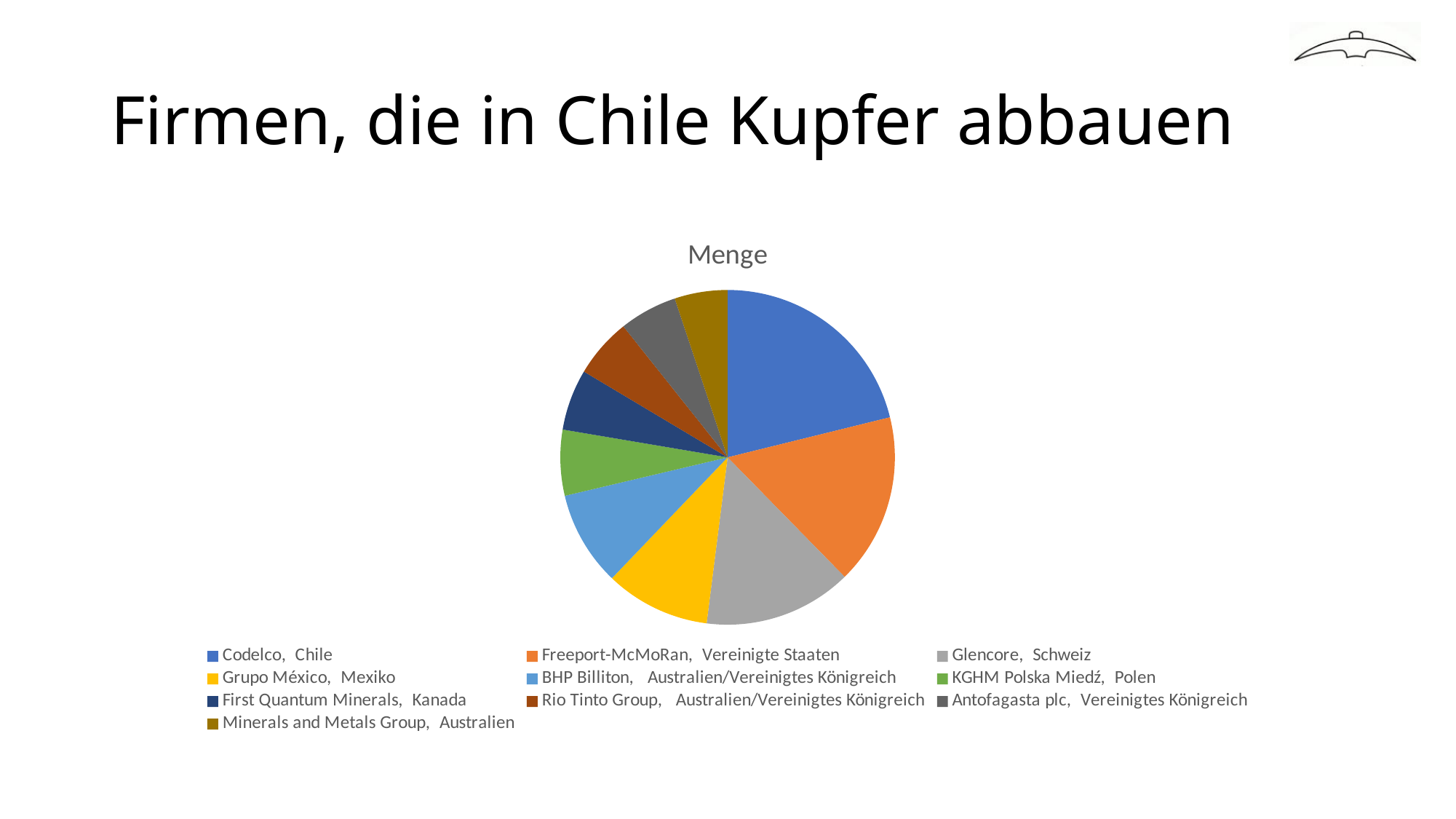
Which company has the largest slice of the pie chart? Codelco, Chile What kind of chart is shown on the slide? pie chart What is the title of the pie chart? Menge Which slice is larger, Codelco or Grupo México? Codelco Which slice is larger, Codelco or Freeport-McMoRan? Codelco According to the legend, which country is listed for Glencore? Schweiz How many companies (slices) does the pie chart show? 10 Which slice is larger, Freeport-McMoRan or Rio Tinto Group? Freeport-McMoRan